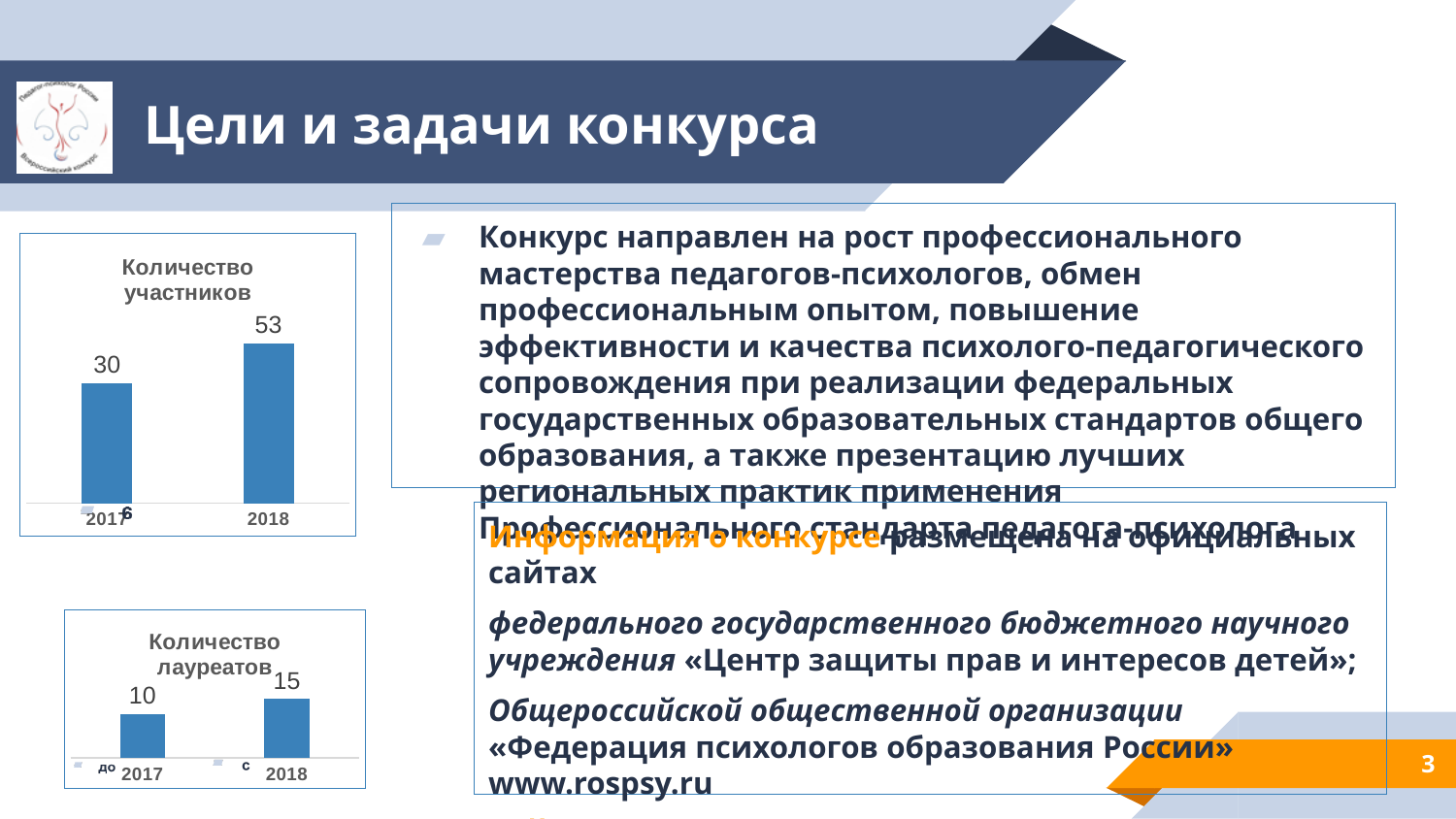
In the chart titled "Количество лауреатов", which year has the lower value? 2017 In the chart titled "Количество участников", what is the value for 2017? 30 Which is larger: the 2017 value in the "Количество участников" chart or the 2018 value in the "Количество лауреатов" chart? the 2017 value in "Количество участников" In the chart titled "Количество участников", what is the value for 2018? 53 What kind of chart is the one titled "Количество участников"? bar chart In the chart titled "Количество участников", which year has the higher value? 2018 In the chart titled "Количество лауреатов", what is the value for 2018? 15 In the chart titled "Количество лауреатов", what is the difference between the 2018 and 2017 values? 5 In the chart titled "Количество участников", what is the difference between the 2018 and 2017 values? 23 In the chart titled "Количество лауреатов", do the values rise or fall from 2017 to 2018? rise In the chart titled "Количество лауреатов", what is the value for 2017? 10 In the chart titled "Количество участников", how many categories are shown on the x axis? 2